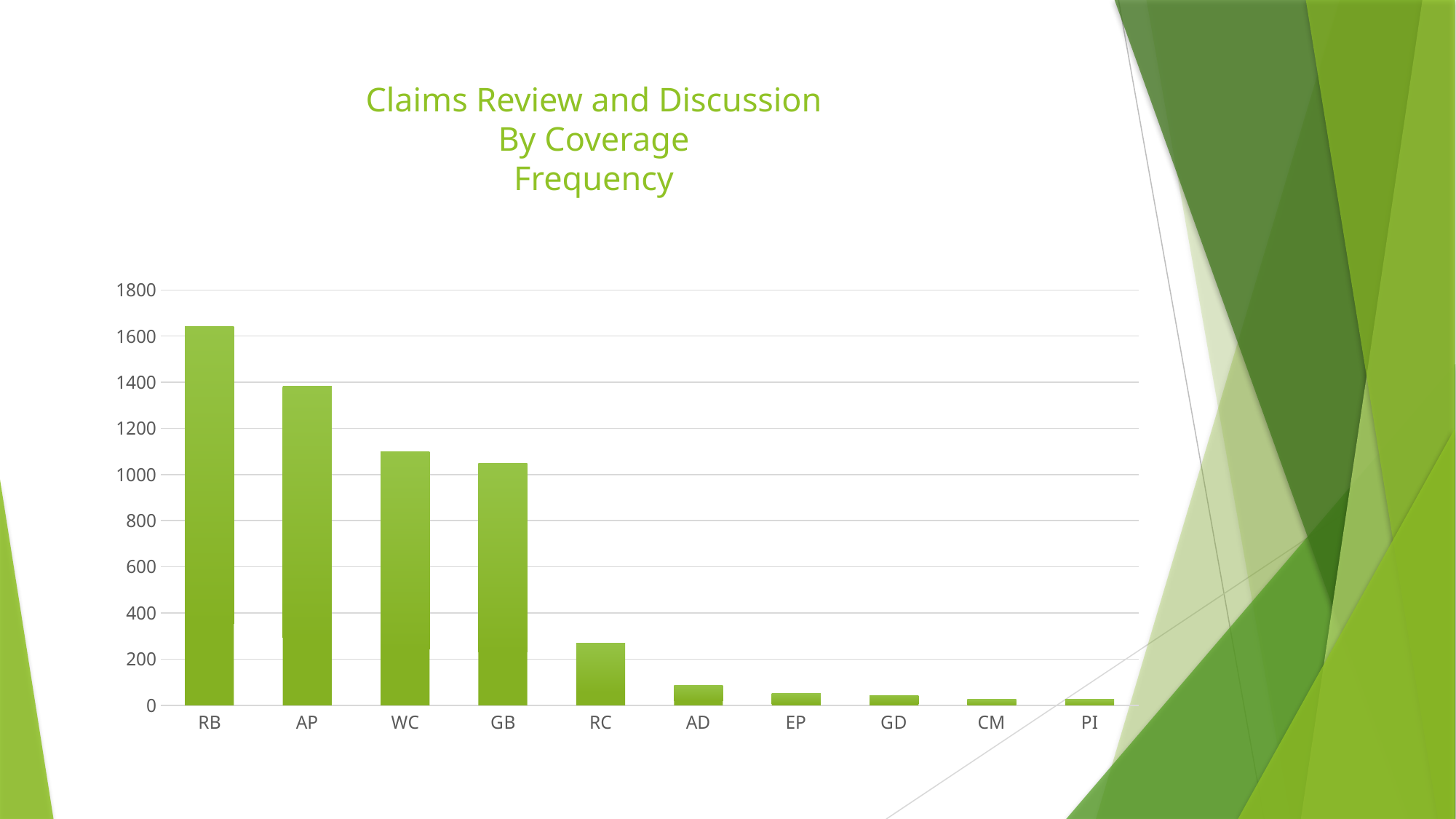
Is the value for GB greater or less than 1200? less Is the value for RC greater or less than 200? greater What kind of chart is shown on the slide? bar chart Which has a higher frequency, RB or AP? RB Is the value for AD greater or less than 200? less Do the values rise or fall moving from left to right along the x axis? fall Which coverage category has the highest frequency? RB What is the title of the chart? Claims Review and Discussion By Coverage Frequency How many coverage categories are shown on the x axis? 10